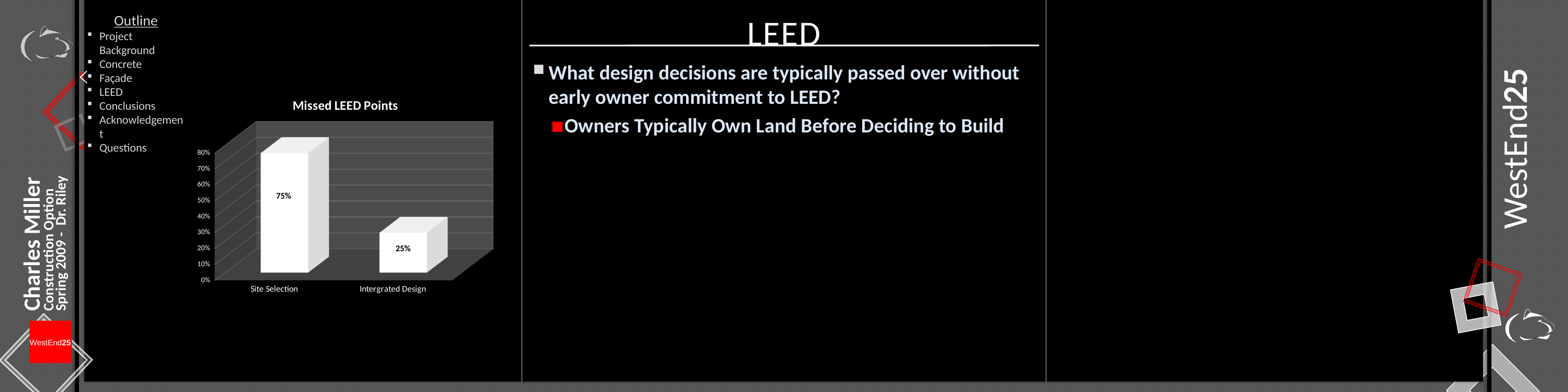
What is the value for Site Selection in the Missed LEED Points chart? 75% Is the value for Site Selection greater or less than 60%? greater How many categories are shown in the Missed LEED Points chart? 2 What is the highest value shown on the vertical axis of the Missed LEED Points chart? 80% What is the value for Intergrated Design in the Missed LEED Points chart? 25% What kind of chart is shown on the slide? bar chart Which is larger in the Missed LEED Points chart, Site Selection or Intergrated Design? Site Selection What is the difference between the Site Selection and Intergrated Design values in the Missed LEED Points chart? 50% Is the value for Intergrated Design greater or less than 50%? less Which category has the highest value in the Missed LEED Points chart? Site Selection What is the title of the chart on the slide? Missed LEED Points Which category has the lowest value in the Missed LEED Points chart? Intergrated Design